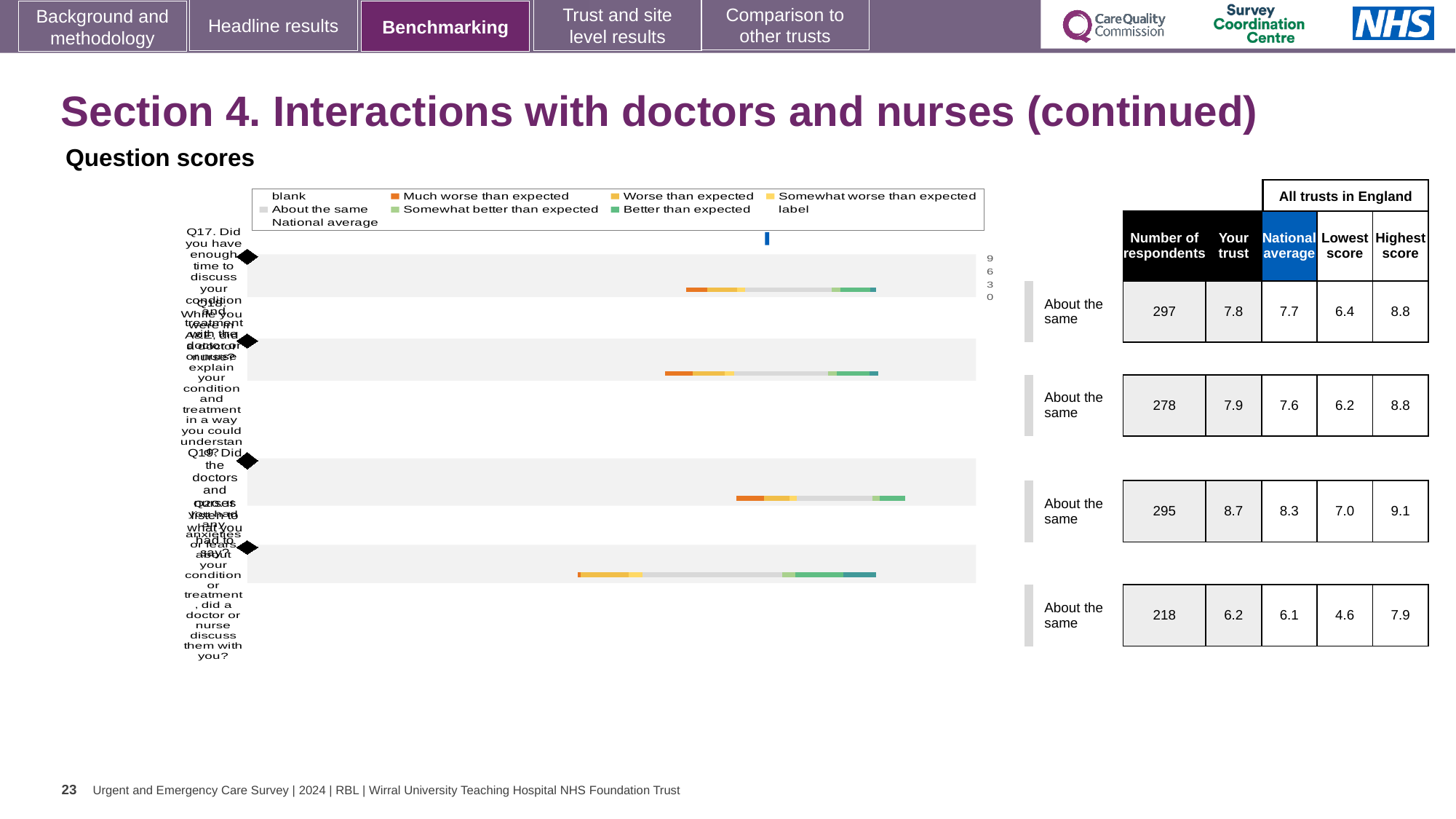
How many respondents are listed for the fourth row (Q20)? 218 What benchmark category is shown for every question in the chart? About the same What kind of chart is shown on the slide? bar chart What is the difference between the 'Your trust' score and the national average for the third row (Q19)? 0.4 Which row has the lowest 'Your trust' score? Q20 (fourth row), 6.2 Is the 'Your trust' score for the first row (Q17) larger or smaller than its national average? larger What is the national average for the third row (Q19)? 8.3 What is the lowest score across all trusts in England for the second row (Q18)? 6.2 How many survey questions (rows) are plotted in the chart? 4 Which row has the highest 'Your trust' score? Q19 (third row), 8.7 Which colour represents 'Much worse than expected' in the legend? orange What is the 'Your trust' score for the first row (Q17) in the table beside the chart? 7.8